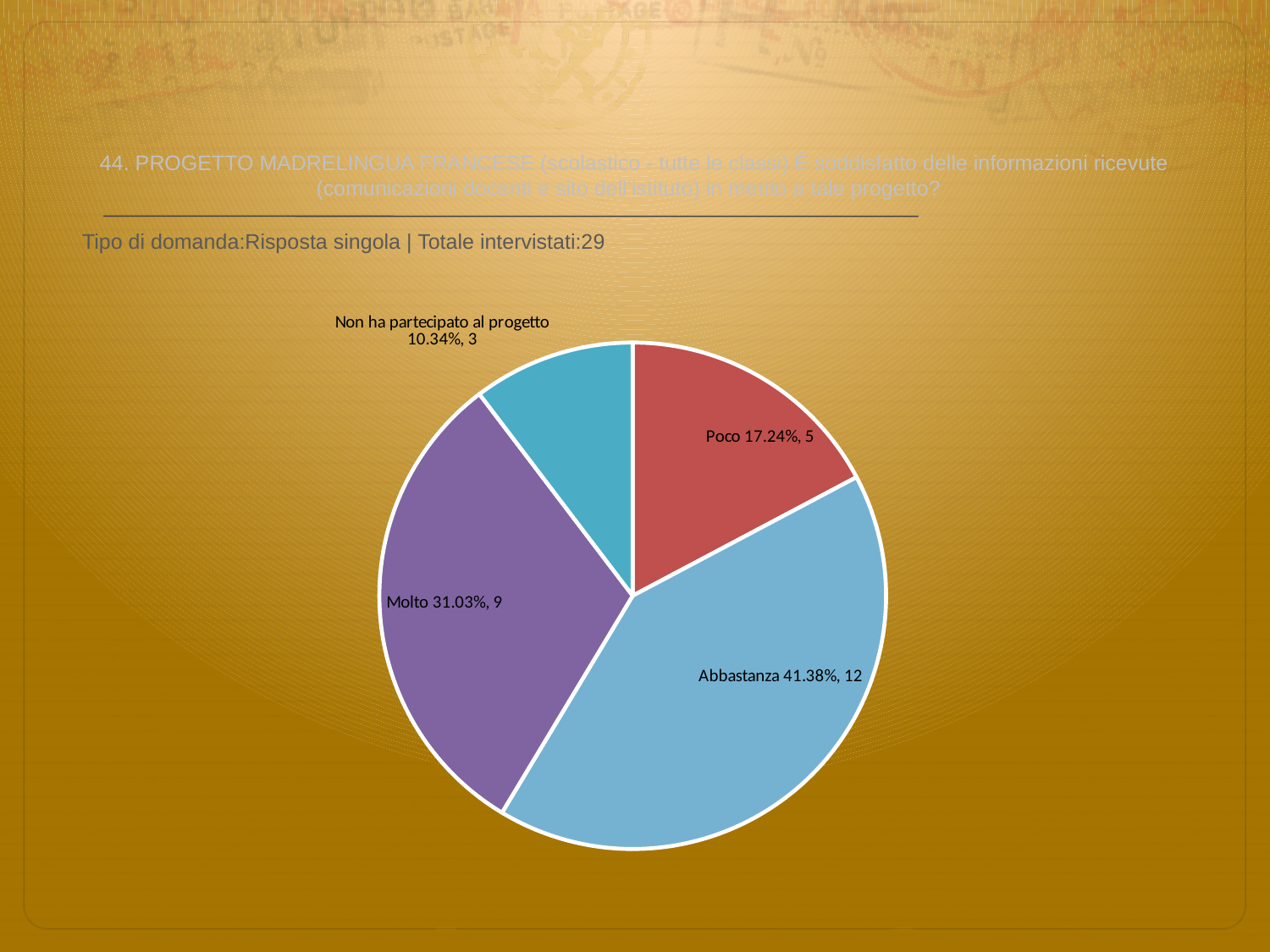
What percentage share does the Abbastanza slice have? 41.38% Which category has the smallest slice? Non ha partecipato al progetto What is the difference in count between Abbastanza and Molto? 3 Which has more respondents, Poco or Molto? Molto What is the total number of respondents shown on the slide? 29 What kind of chart is shown on the slide? pie chart What colour is the Molto slice? purple What percentage share does the Poco slice have? 17.24% How many respondents answered Non ha partecipato al progetto? 3 How many slices does the pie chart have? 4 How many respondents answered Molto? 9 Which category has the largest slice? Abbastanza